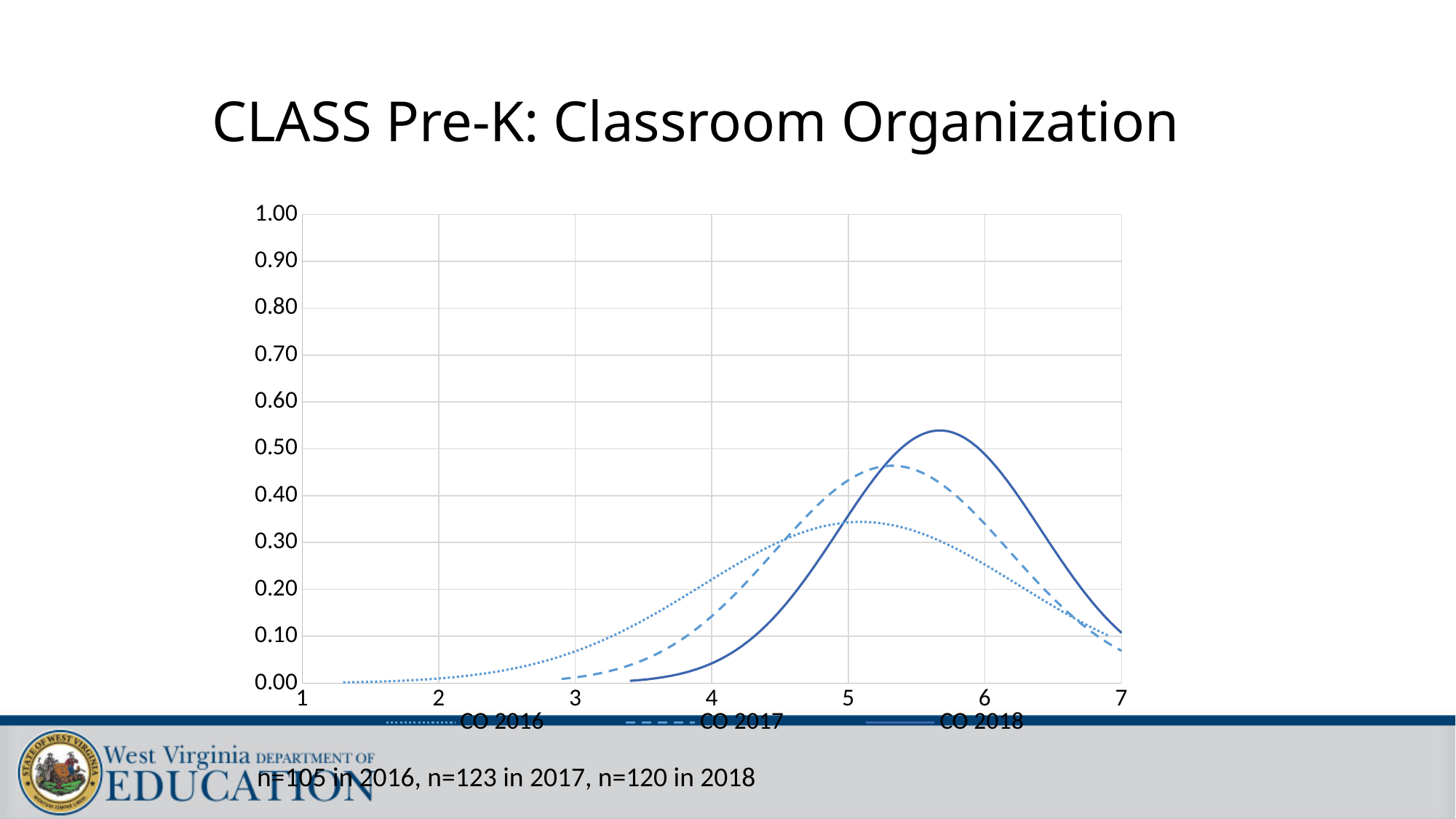
Is the peak value of the CO 2018 curve greater or less than 0.50? greater How many tick labels are shown on the x axis? 7 Is the peak value of the CO 2017 curve greater or less than 0.50? less What kind of chart is shown on the slide? Line chart Which series has the lowest peak value? CO 2016 How many series does the legend list? 3 Which series is drawn with a solid line? CO 2018 Which curve has the higher peak, CO 2017 or CO 2016? CO 2017 Is the peak value of the CO 2016 curve greater or less than 0.40? less Which series reaches the highest peak value? CO 2018 What is the title of the chart? CLASS Pre-K: Classroom Organization Does the CO 2018 curve rise or fall between x = 6 and x = 7? fall